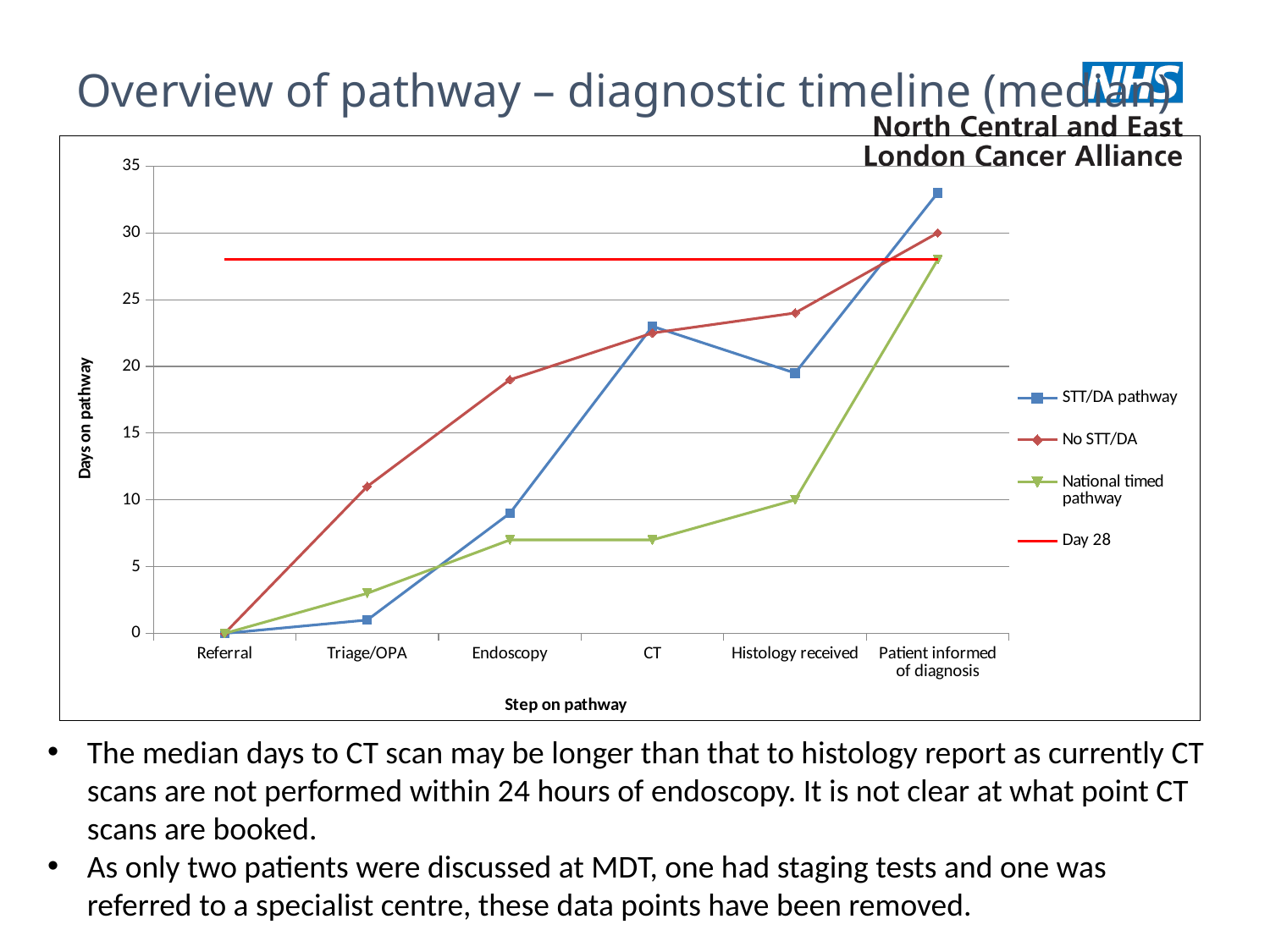
What kind of chart is shown on the slide? line chart Is the value for the STT/DA pathway at Patient informed of diagnosis greater or less than 30? greater What is the label of the horizontal red reference line in the legend? Day 28 What is the value for the STT/DA pathway at Referral? 0 What is the value for the National timed pathway at Histology received? 10 Is the value for the National timed pathway at CT greater or less than 10? less How many steps on the pathway are shown along the x axis? 6 Is the value for No STT/DA at Histology received greater or less than 25? less At Endoscopy, which is larger: the STT/DA pathway or No STT/DA? No STT/DA How many series does the legend list? 4 At which step on the pathway is the STT/DA pathway value highest? Patient informed of diagnosis What is the value for No STT/DA at Patient informed of diagnosis? 30